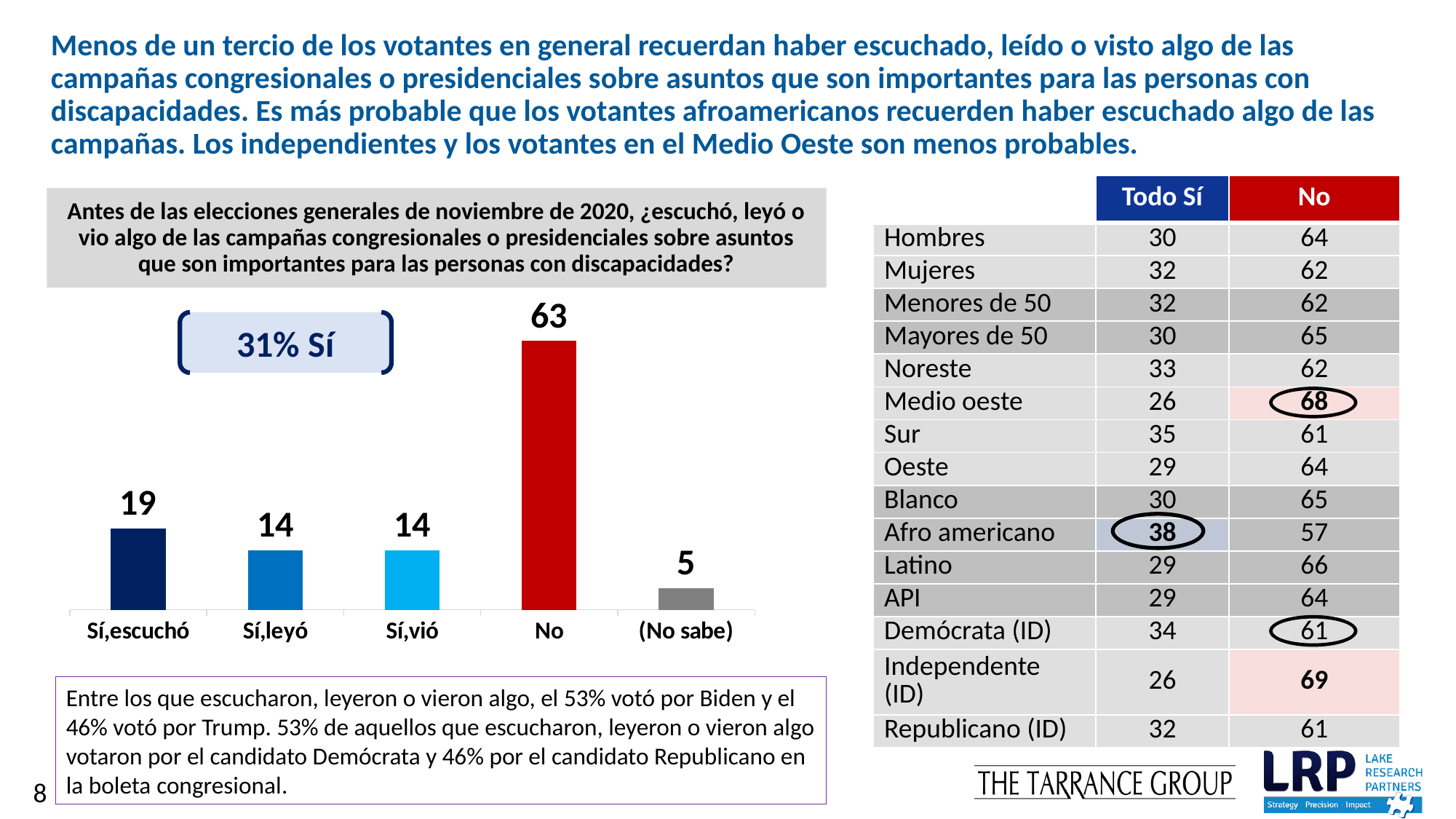
Which category has the lowest value in the bar chart? (No sabe) What colour is the "No" bar in the bar chart? Red What percentage is shown in the callout box next to the bar chart? 31% Sí What is the value for the "No" bar in the bar chart? 63 What type of chart is shown on the left of the slide? Bar chart What is the difference between the "No" bar and the "Sí,escuchó" bar? 44 What is the value for "(No sabe)" in the bar chart? 5 Which is larger in the bar chart, "Sí,escuchó" or "Sí,vió"? Sí,escuchó What is the value for "Sí,escuchó" in the bar chart? 19 How many categories are shown in the bar chart? 5 Which category has the highest value in the bar chart? No What is the value for "Sí,leyó" in the bar chart? 14